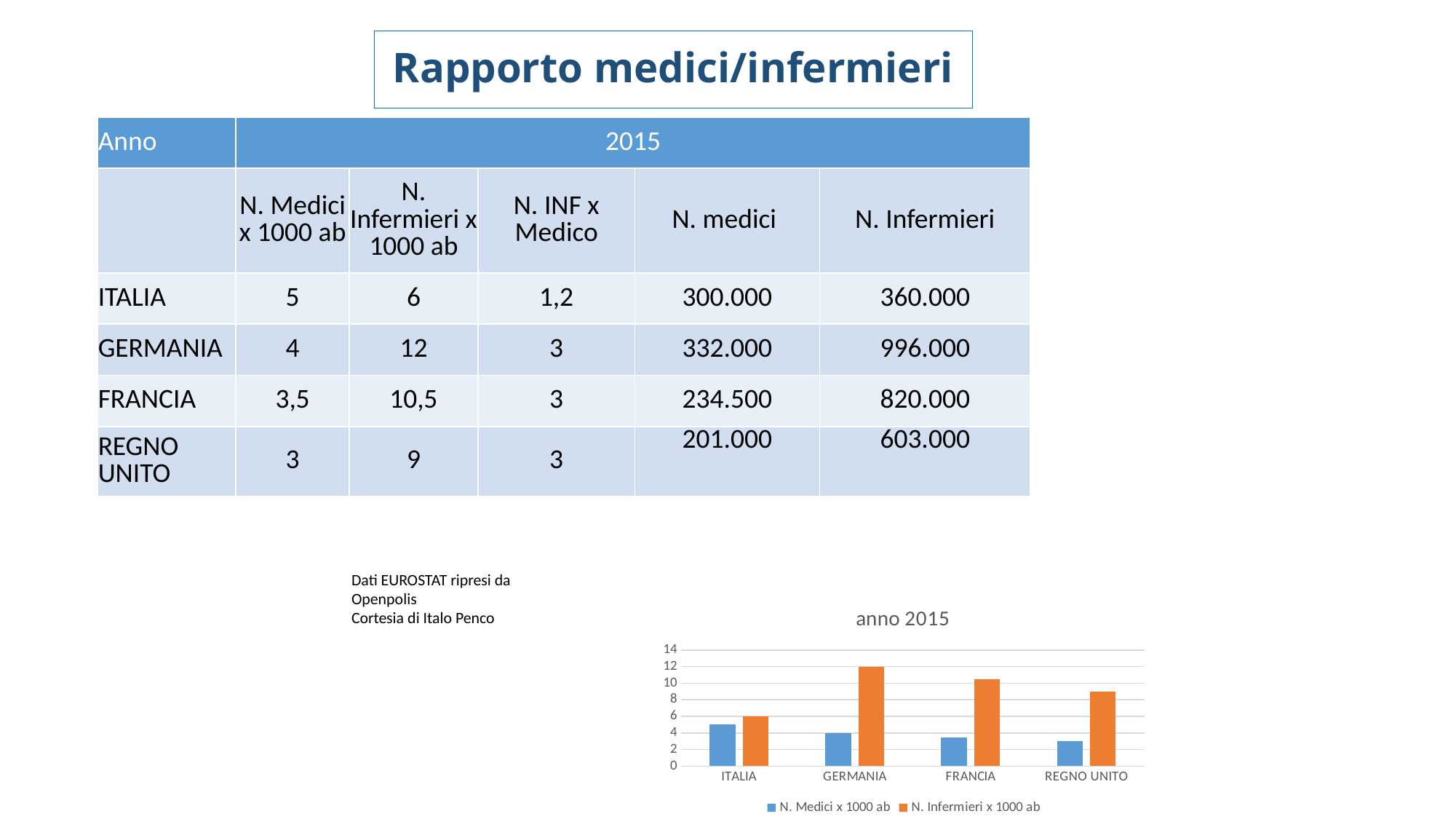
What is the title of the chart? anno 2015 In the chart, what is the value of N. Medici x 1000 ab for GERMANIA? 4 How many countries are shown on the x axis of the chart? 4 Is the N. Infermieri x 1000 ab value for FRANCIA greater or less than 10? greater How many series does the chart legend list? 2 Which country has the highest N. Infermieri x 1000 ab bar in the chart? GERMANIA In the chart, what is the value of N. Infermieri x 1000 ab for GERMANIA? 12 Which country has the highest N. Medici x 1000 ab bar in the chart? ITALIA What kind of chart is shown on the slide? bar chart Which series is drawn in orange in the chart? N. Infermieri x 1000 ab In the chart, what is the difference between N. Infermieri x 1000 ab and N. Medici x 1000 ab for GERMANIA? 8 Which country has the lowest N. Infermieri x 1000 ab bar in the chart? ITALIA